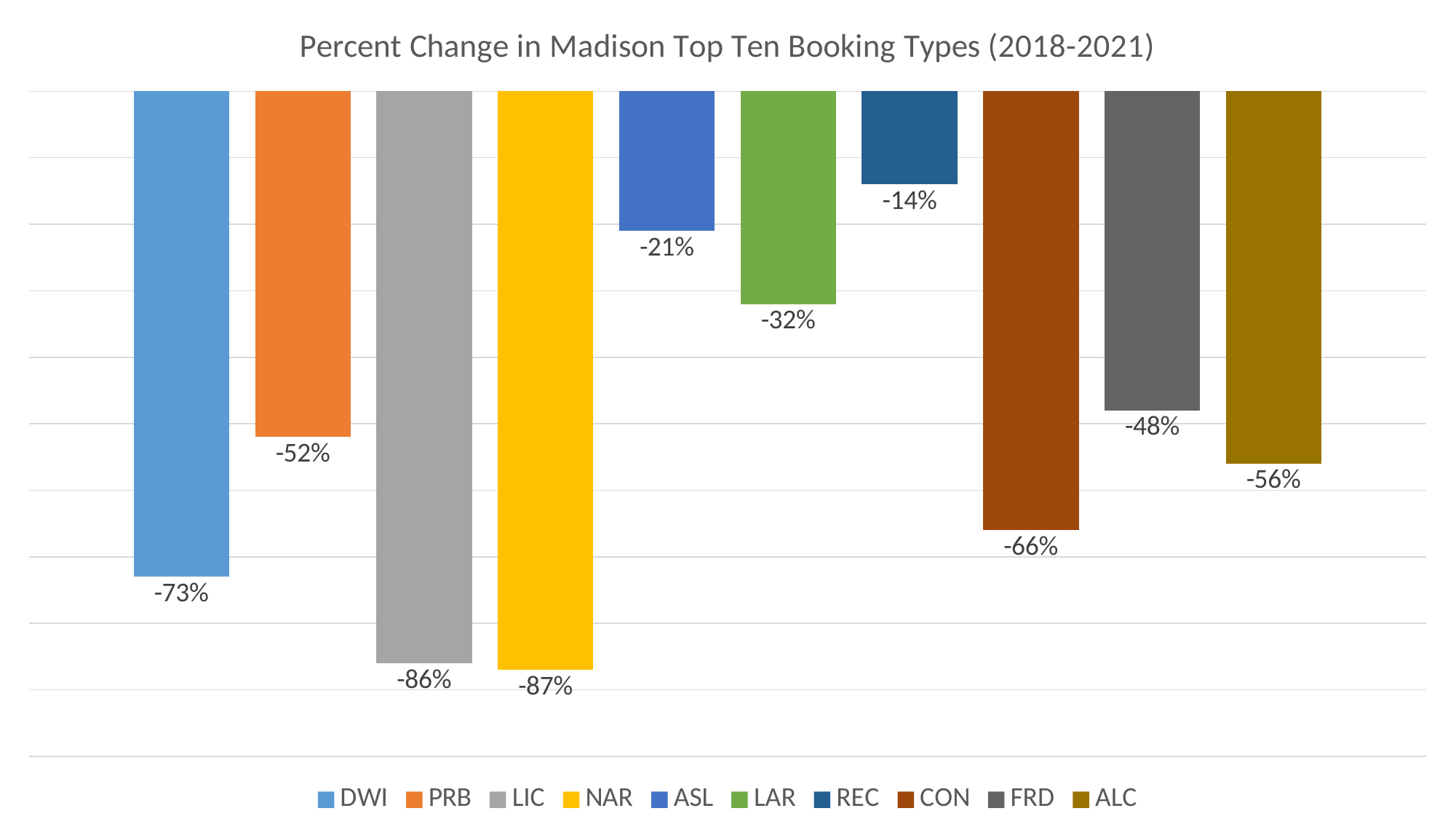
What is the percent change for REC? -14% What is the difference in percentage points between the values for DWI and PRB? 21 percentage points How many booking types are shown in the chart? 10 How many entries does the legend list? 10 What kind of chart is shown on the slide? Bar chart What is the percent change for FRD? -48% Which has a larger percent decrease, LAR or ALC? ALC Which booking type shows the smallest percent decrease? REC What is the percent change for DWI? -73% What is the title of the chart? Percent Change in Madison Top Ten Booking Types (2018-2021) What is the percent change for CON? -66% Which booking type shows the largest percent decrease? NAR